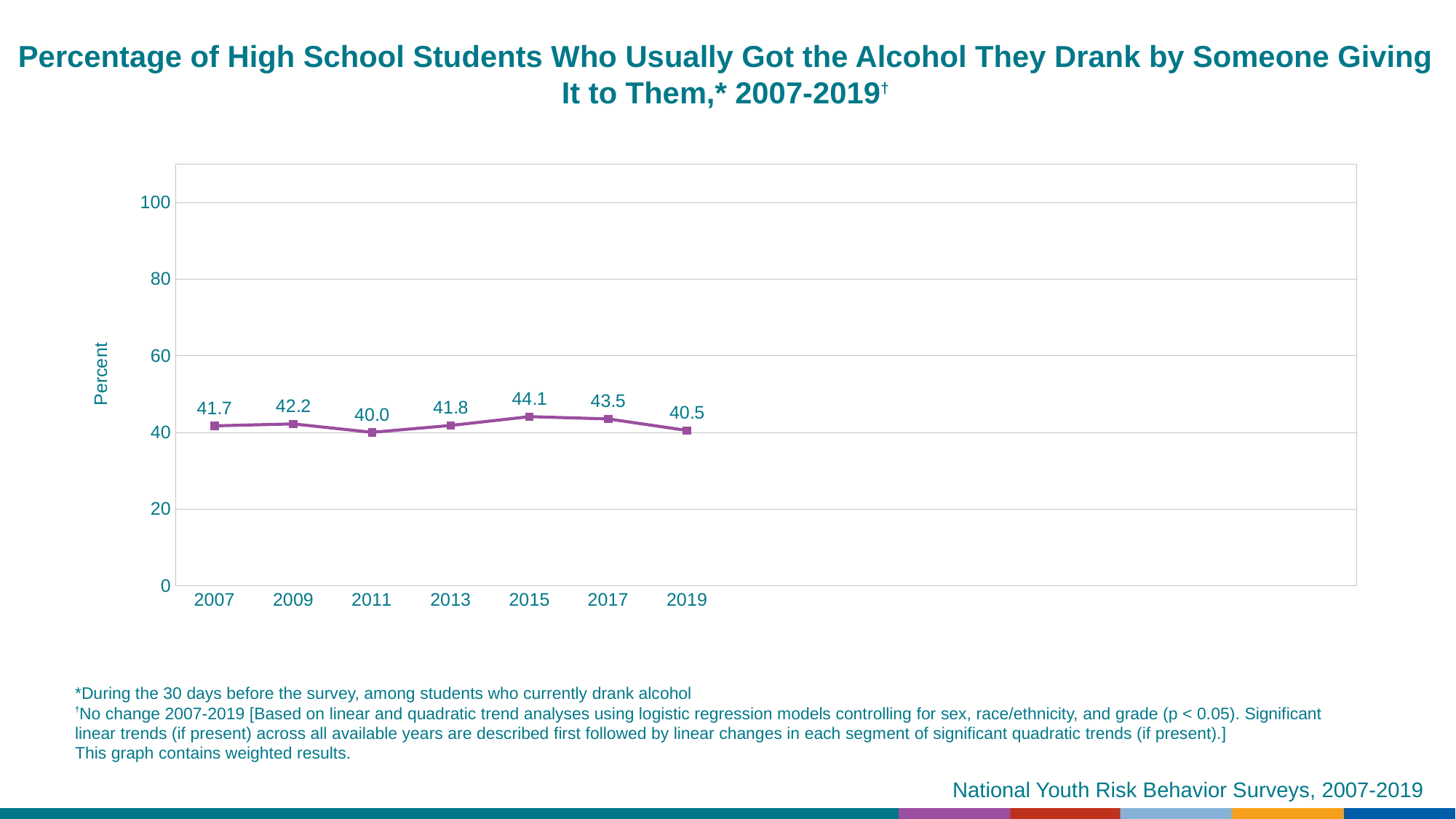
Which year has the highest value? 2015 What is the value for 2007? 41.7 What kind of chart is shown on the slide? line chart Which year has the lowest value? 2011 What is the difference between the values for 2015 and 2011? 4.1 Which is larger, the value for 2009 or the value for 2019? 2009 What is the value for 2015? 44.1 What is the label on the y axis? Percent How many years are plotted on the chart? 7 What is the value for 2019? 40.5 Is the value for 2017 greater or less than 60? less Does the value rise or fall from 2017 to 2019? fall